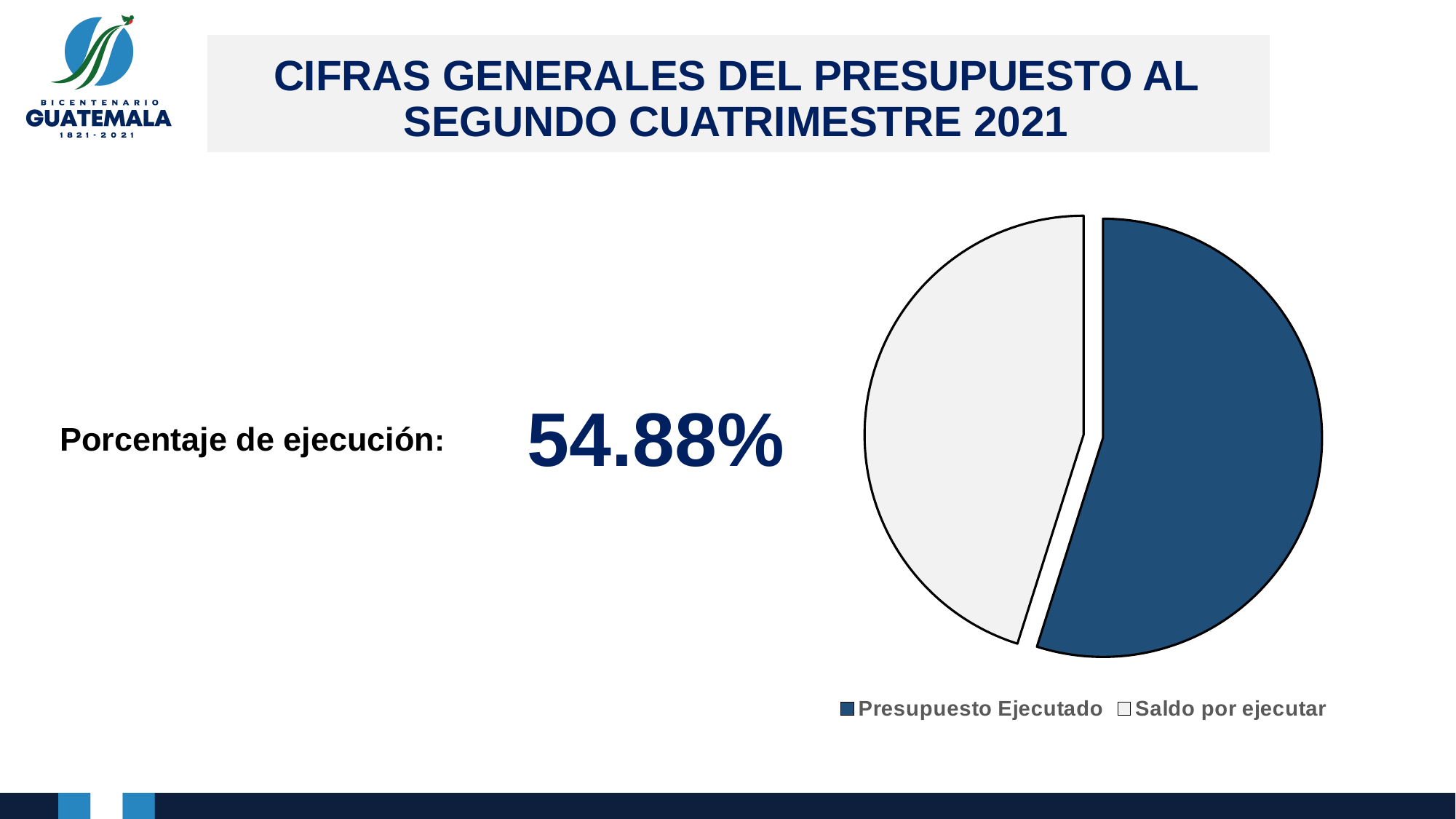
How many entries does the legend of the pie chart list? 2 Which slice of the pie chart is the smallest? Saldo por ejecutar What kind of chart is shown on the slide? Pie chart Which slice of the pie chart is the largest? Presupuesto Ejecutado Which is larger in the pie chart, Presupuesto Ejecutado or Saldo por ejecutar? Presupuesto Ejecutado How many slices does the pie chart have? 2 Is the share of Saldo por ejecutar in the pie chart greater or less than 50%? less Is the share of Presupuesto Ejecutado in the pie chart greater or less than 50%? greater What colour is the Presupuesto Ejecutado slice in the pie chart? Dark blue What are the two legend entries of the pie chart? Presupuesto Ejecutado and Saldo por ejecutar What percentage of the budget does the Presupuesto Ejecutado slice represent, according to the slide? 54.88%